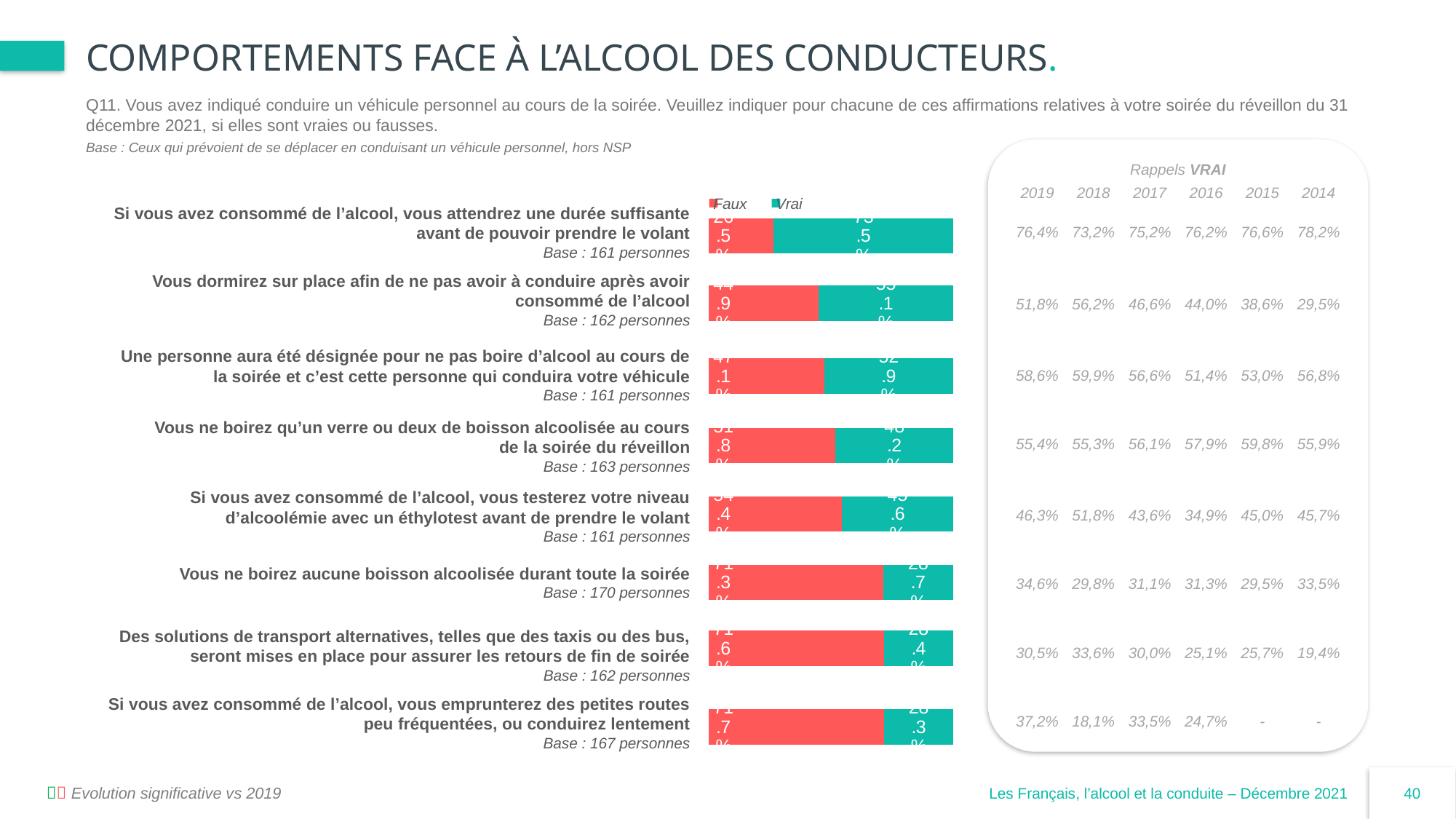
For the statement 'Vous ne boirez aucune boisson alcoolisée durant toute la soirée', which is larger: Faux or Vrai? Faux Which colour represents the 'Vrai' series in the chart? Teal (green) Which statement has the smallest 'Faux' share in the chart? Si vous avez consommé de l'alcool, vous attendrez une durée suffisante avant de pouvoir prendre le volant How many statements (categories) are plotted in the chart? 8 For the statement 'Si vous avez consommé de l'alcool, vous attendrez une durée suffisante avant de pouvoir prendre le volant', which is larger: Faux or Vrai? Vrai For the statement 'Des solutions de transport alternatives, telles que des taxis ou des bus, seront mises en place pour assurer les retours de fin de soirée', which is larger: Faux or Vrai? Faux How many series does the chart legend list? 2 Which statement has the largest 'Vrai' share in the chart? Si vous avez consommé de l'alcool, vous attendrez une durée suffisante avant de pouvoir prendre le volant What kind of chart is shown on the slide? Stacked bar chart What is the base (number of people) shown for the statement 'Vous ne boirez aucune boisson alcoolisée durant toute la soirée'? 170 personnes What are the two series named in the chart legend? Faux and Vrai